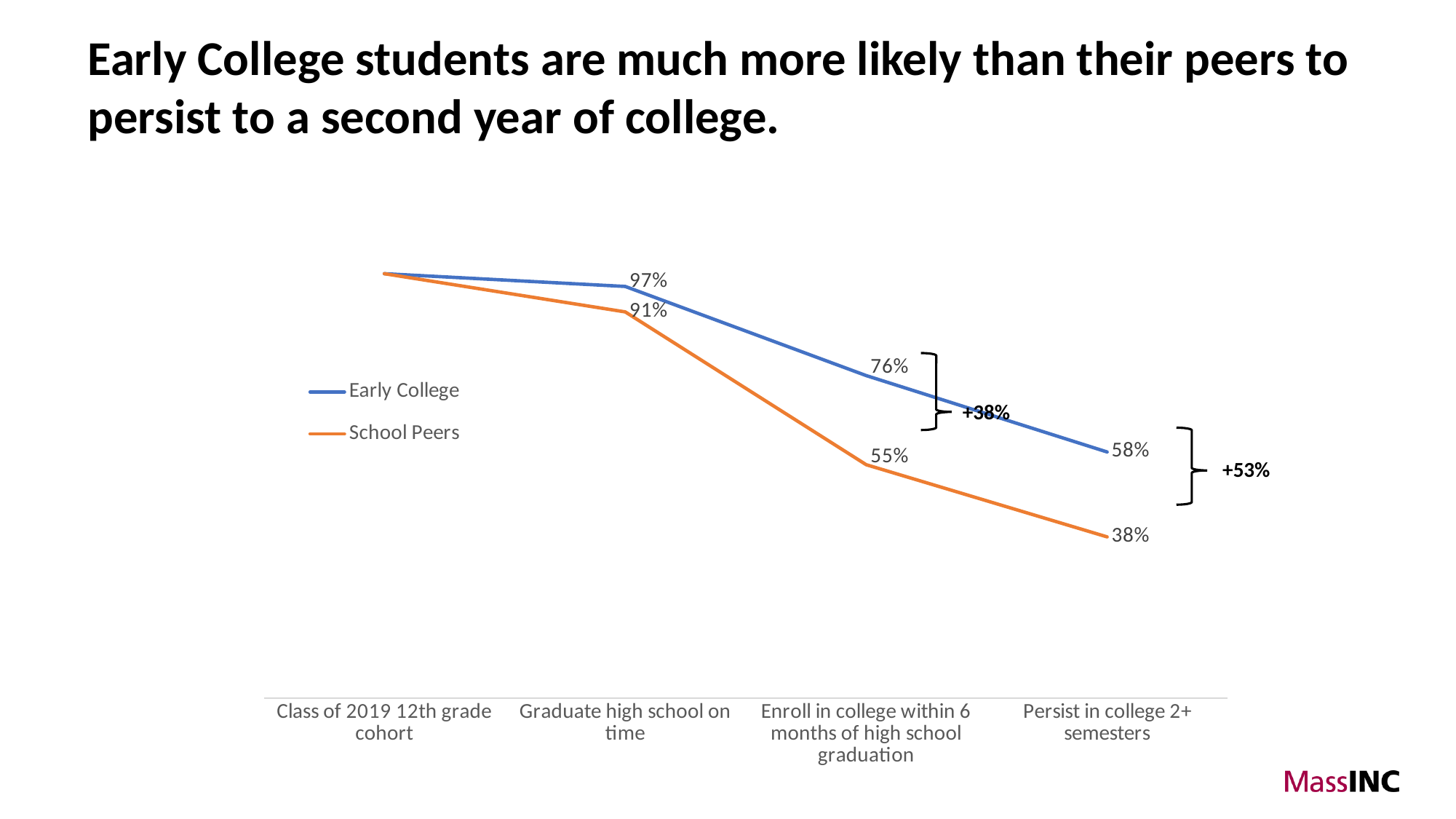
How many categories are shown along the x axis? 4 What is the School Peers value for "Persist in college 2+ semesters"? 38% What is the Early College value for "Enroll in college within 6 months of high school graduation"? 76% What is the Early College value for "Graduate high school on time"? 97% Which series has the higher value for "Persist in college 2+ semesters"? Early College What kind of chart is shown on the slide? line chart Do the School Peers values rise or fall from left to right along the x axis? fall What is the difference between the Early College and School Peers values for "Enroll in college within 6 months of high school graduation"? 21% What is the difference between the Early College and School Peers values for "Persist in college 2+ semesters"? 20% How many series does the legend list? 2 What is the School Peers value for "Graduate high school on time"? 91% What annotation is shown next to the bracket at "Persist in college 2+ semesters"? +53%